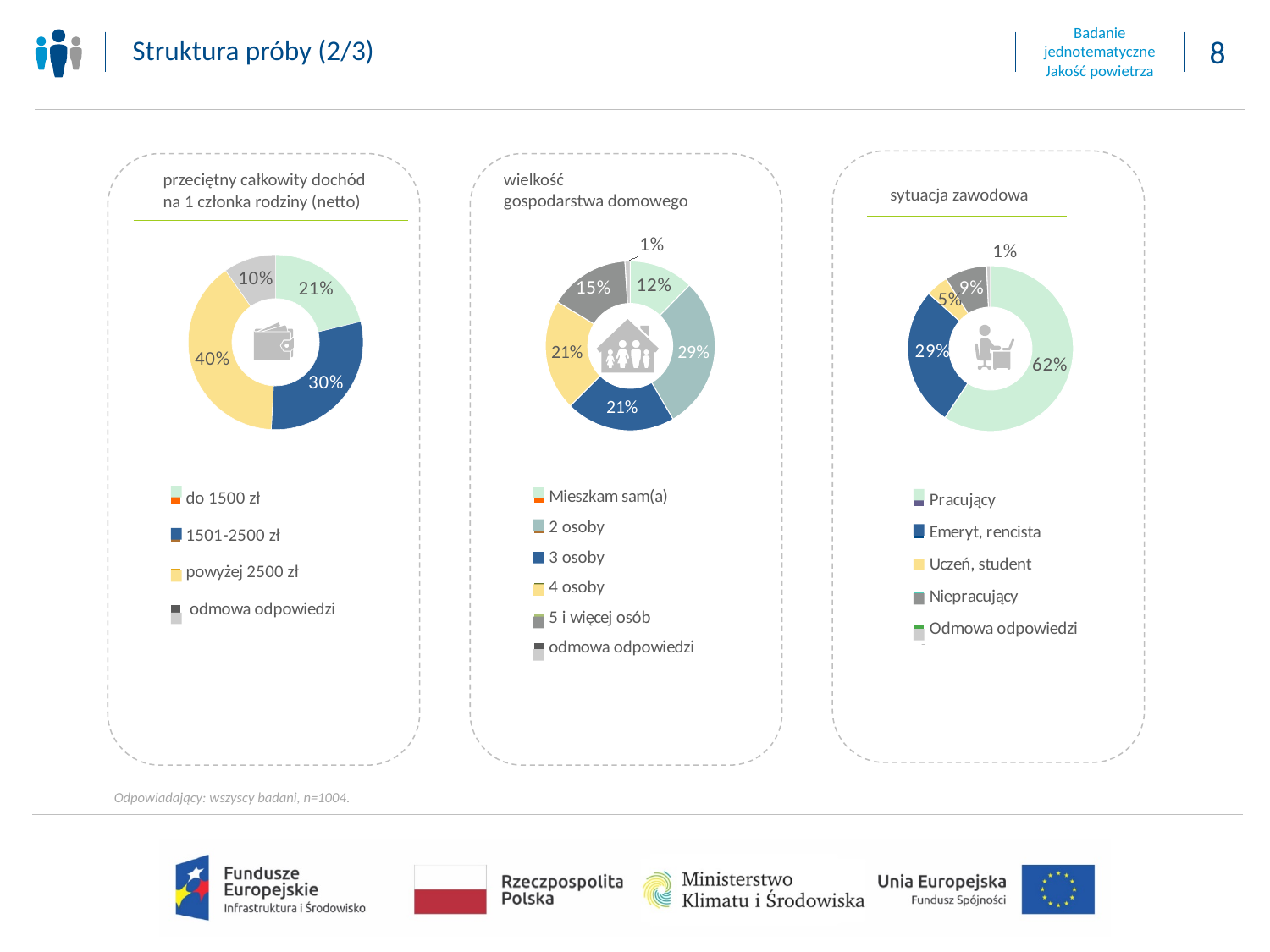
In the 'wielkość gospodarstwa domowego' chart, what share is '5 i więcej osób'? 15% In the 'przeciętny całkowity dochód na 1 członka rodziny (netto)' chart, what share is 'powyżej 2500 zł'? 40% What kind of chart is used for 'sytuacja zawodowa'? Donut (pie) chart In the 'sytuacja zawodowa' chart, what share is 'Pracujący'? 62% In the 'sytuacja zawodowa' chart, what is the difference between 'Pracujący' and 'Emeryt, rencista'? 33% In the 'wielkość gospodarstwa domowego' chart, what share is '2 osoby'? 29% In the 'sytuacja zawodowa' chart, which is larger, 'Uczeń, student' or 'Niepracujący'? Niepracujący In the 'przeciętny całkowity dochód na 1 członka rodziny (netto)' chart, which category has the smallest share? odmowa odpowiedzi How many categories does the legend of the 'wielkość gospodarstwa domowego' chart list? 6 In the 'wielkość gospodarstwa domowego' chart, which category has the largest share? 2 osoby In the 'przeciętny całkowity dochód na 1 członka rodziny (netto)' chart, what is the difference between '1501-2500 zł' and 'do 1500 zł'? 9% How many charts are shown on the slide? 3